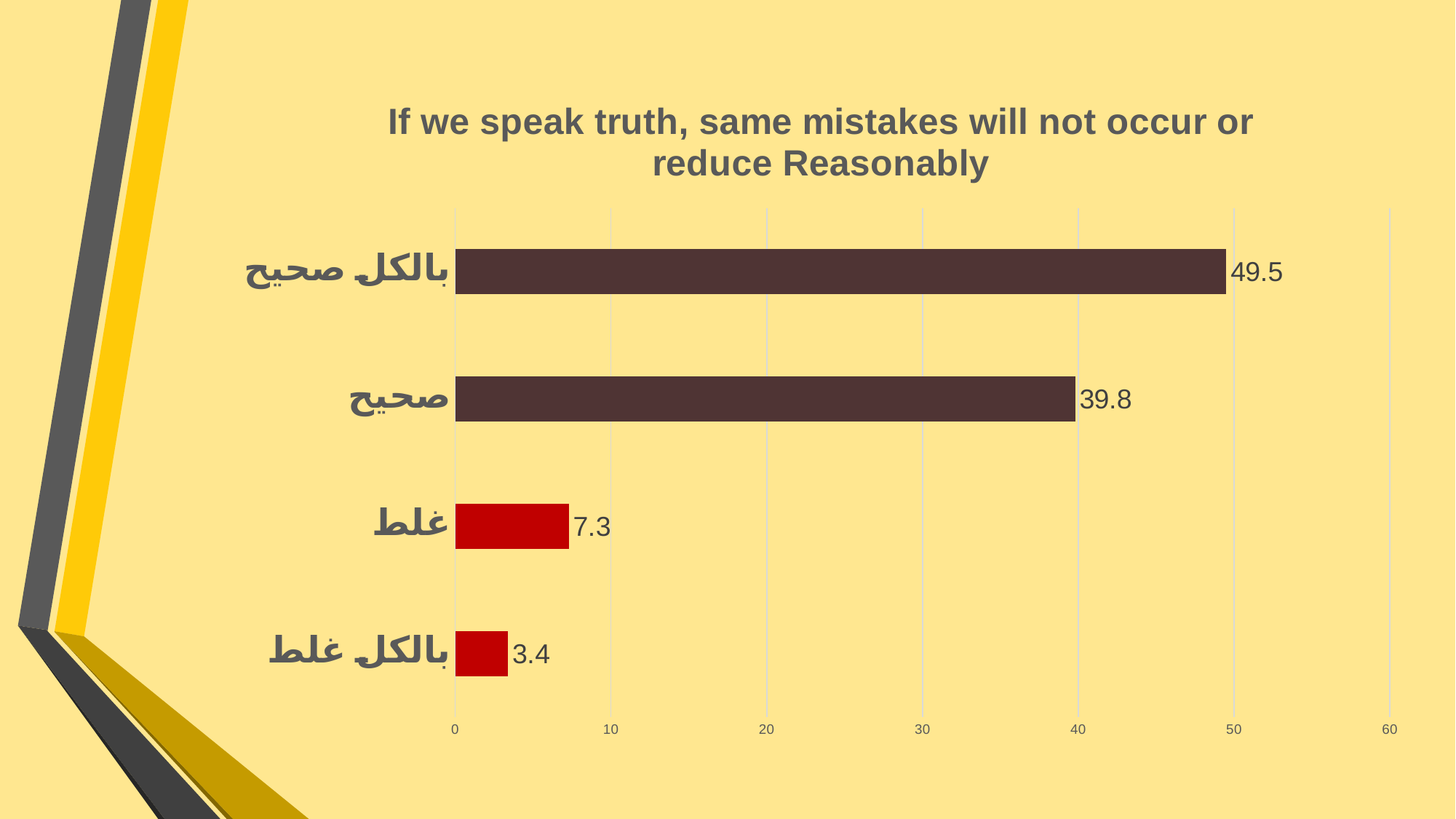
Which is larger, the value for صحيح or the value for غلط? صحيح What is the difference between the values for غلط and بالكل غلط? 3.9 What is the value for صحيح? 39.8 What is the difference between the values for بالكل صحيح and صحيح? 9.7 What is the value for غلط? 7.3 What is the value for بالكل غلط? 3.4 What kind of chart is shown on the slide? Bar chart Which category has the lowest value? بالكل غلط How many categories are shown in the chart? 4 What is the value for بالكل صحيح? 49.5 Which category has the highest value? بالكل صحيح What is the title of the chart? If we speak truth, same mistakes will not occur or reduce Reasonably